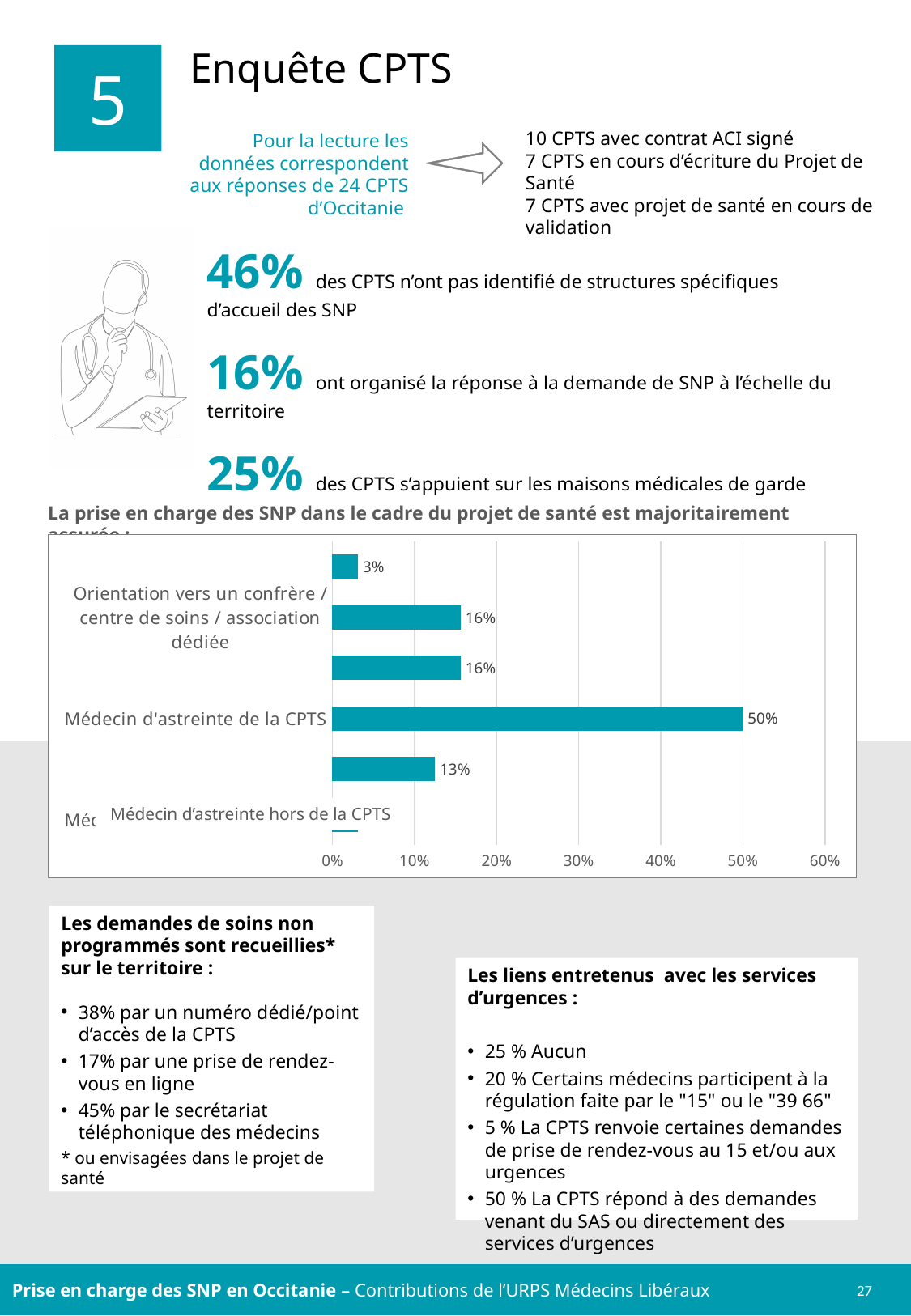
How many bars are plotted in the chart? 6 What is the smallest value shown on any bar in the chart? 3% What colour are the bars in the chart? Teal What is the value for "Médecin d'astreinte de la CPTS" in the bar chart? 50% Which is larger: the value for "Médecin d'astreinte de la CPTS" or the value for "Orientation vers un confrère / centre de soins / association dédiée"? Médecin d'astreinte de la CPTS What is the value for "Orientation vers un confrère / centre de soins / association dédiée" in the bar chart? 16% What is the highest value shown on the horizontal axis of the chart? 60% How many bars in the chart have a value of 16%? 2 What kind of chart is shown on the slide? Bar chart Is the value for "Médecin d'astreinte de la CPTS" greater or less than 40%? greater Which category has the highest value in the bar chart? Médecin d'astreinte de la CPTS What is the difference between the value for "Médecin d'astreinte de la CPTS" and the value for "Orientation vers un confrère / centre de soins / association dédiée"? 34 percentage points